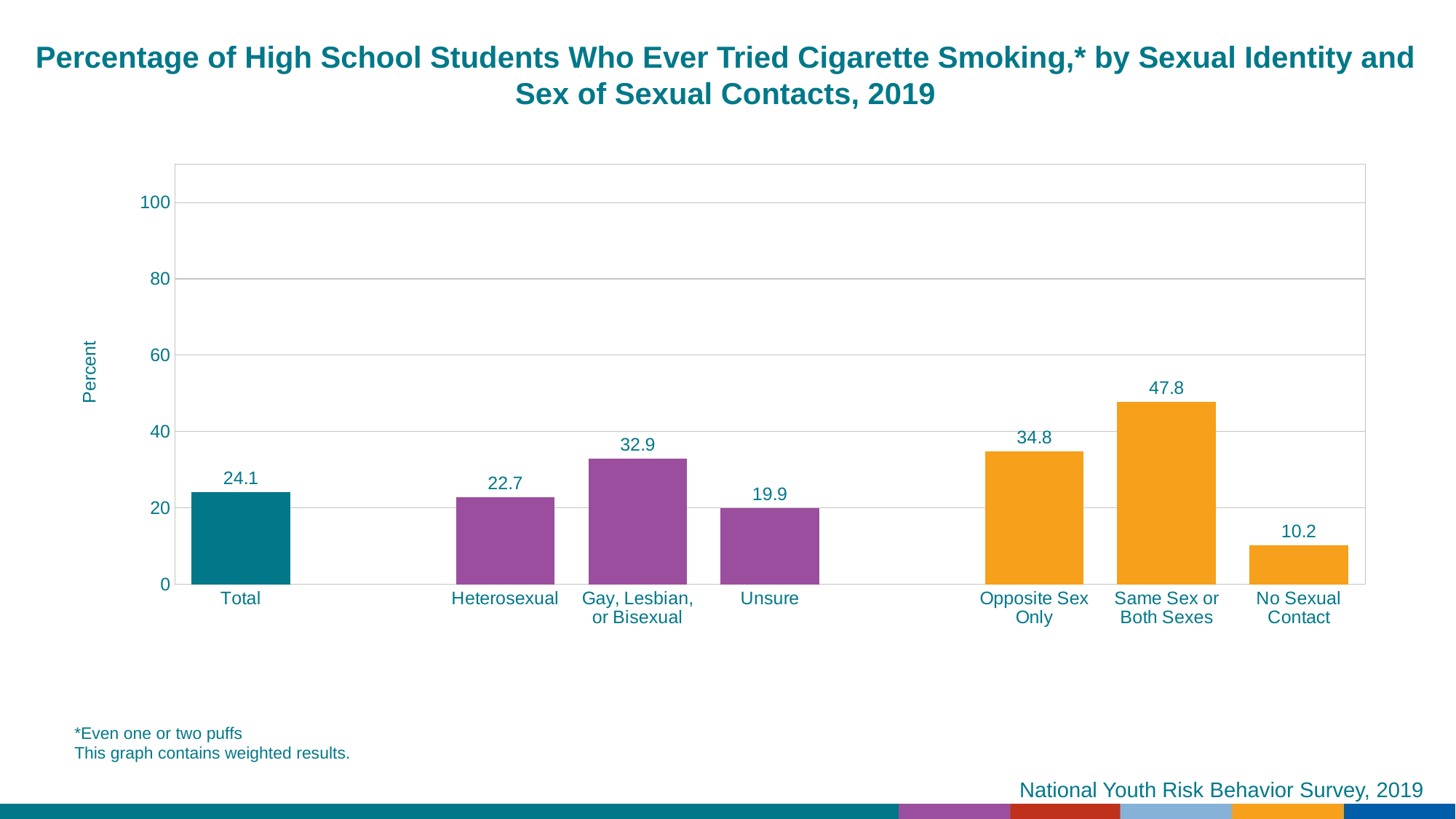
What is the value for Same Sex or Both Sexes? 47.8 Which category has the lowest value? No Sexual Contact What is the value for No Sexual Contact? 10.2 How many categories are shown on the chart? 7 What is the value for Gay, Lesbian, or Bisexual? 32.9 What is the value for Total? 24.1 Which category has the highest value? Same Sex or Both Sexes What kind of chart is shown on the slide? Bar chart Which is larger, the value for Heterosexual or the value for Unsure? Heterosexual What is the difference between the values for Same Sex or Both Sexes and Opposite Sex Only? 13.0 What is the difference between the values for Gay, Lesbian, or Bisexual and Heterosexual? 10.2 Is the value for Opposite Sex Only greater or less than 40? less